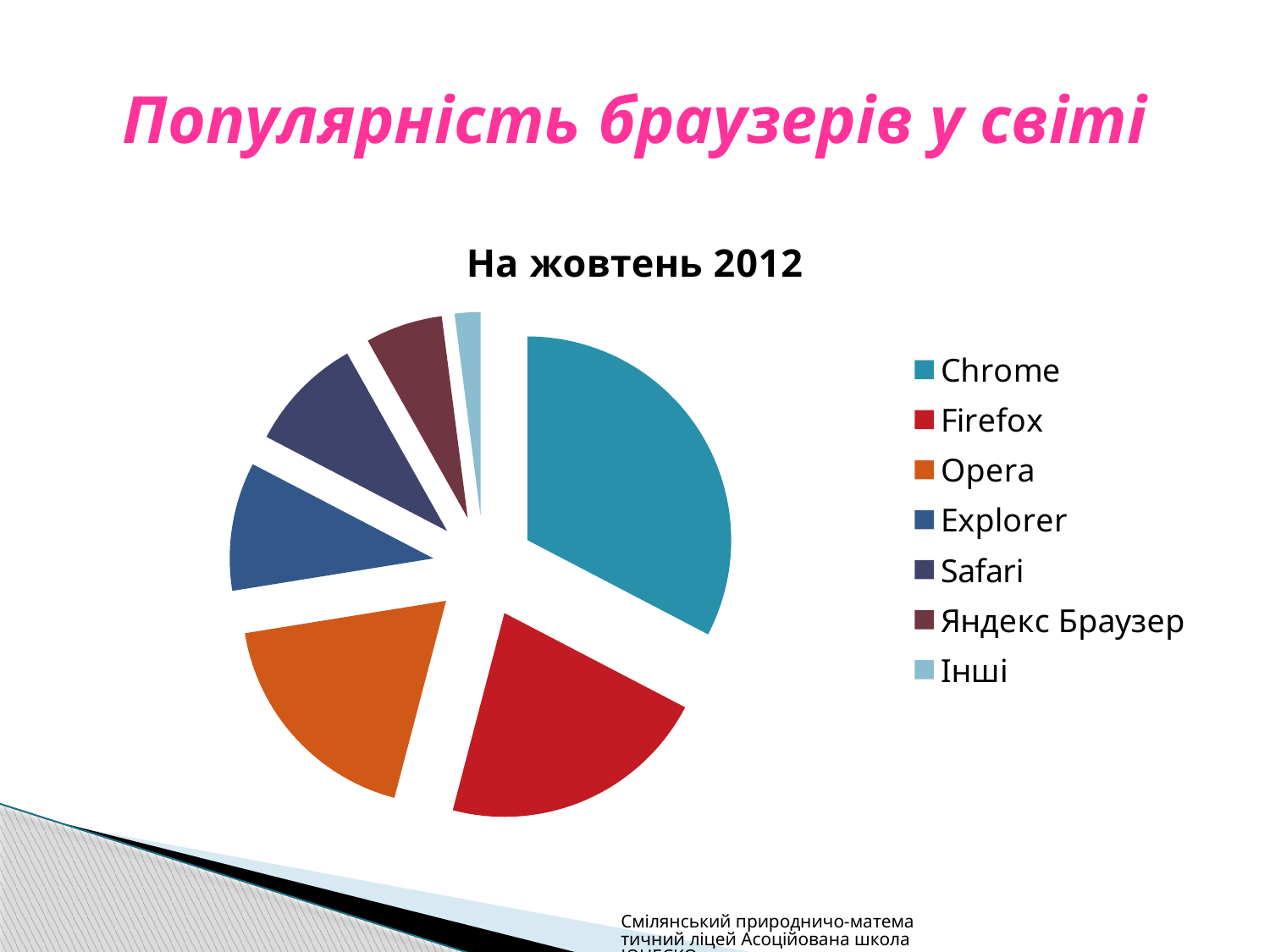
Which slice is larger, Opera or Explorer? Opera What is the title of the chart? На жовтень 2012 Which category has the smallest slice of the pie? Інші How many entries does the legend list? 7 Which slice is larger, Яндекс Браузер or Інші? Яндекс Браузер What kind of chart is shown on the slide? Pie chart Which legend entry is listed last? Інші Which slice is larger, Chrome or Firefox? Chrome How many slices does the pie chart have? 7 Which browser has the largest slice of the pie? Chrome